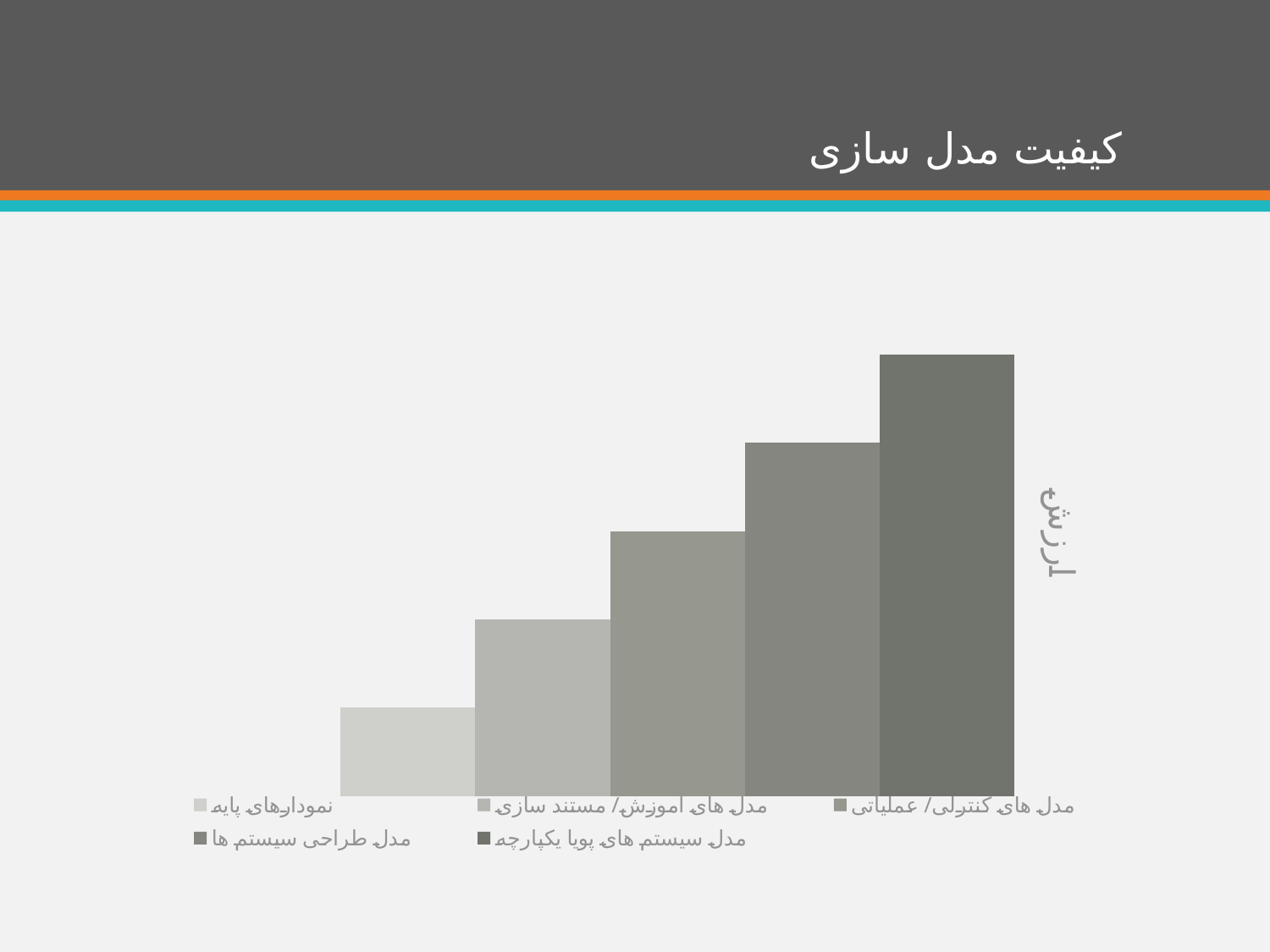
How many bars are plotted in the chart? 5 Which is larger, the bar for مدل های کنترلی/ عملیاتی or the bar for نمودارهای پایه? مدل های کنترلی/ عملیاتی What label is shown on the vertical axis of the chart? ارزش How many series does the legend list? 5 Which is larger, the bar for مدل طراحی سیستم ها or the bar for مدل های آموزش/ مستند سازی? مدل طراحی سیستم ها Which series has the shortest bar in the chart? نمودارهای پایه Do the bar heights rise or fall from left to right across the chart? rise What is the title of the slide containing the chart? کیفیت مدل سازی What kind of chart is shown on the slide? bar chart Which series has the tallest bar in the chart? مدل سیستم های پویا یکپارچه